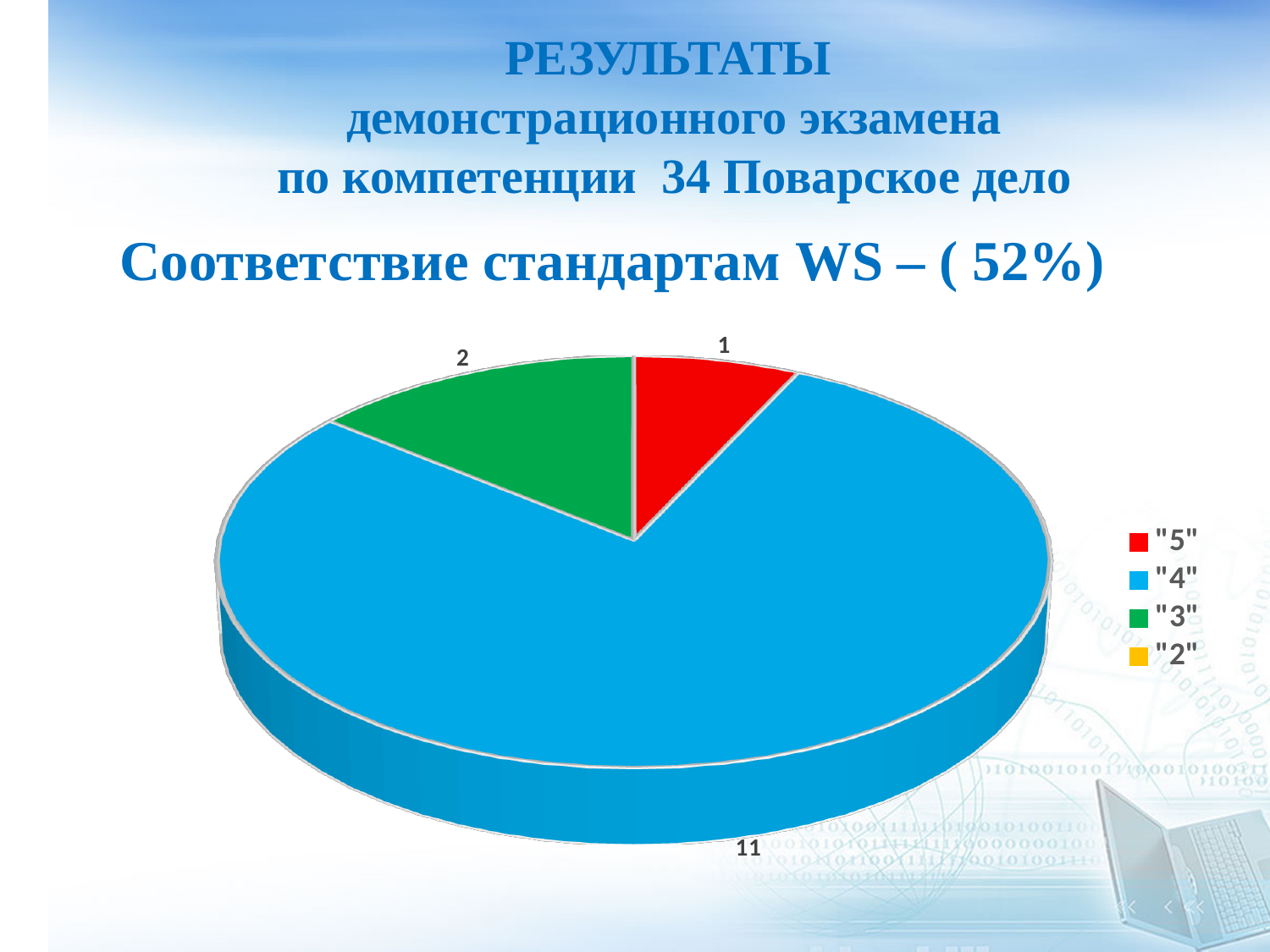
Which is larger in the pie chart, the value for "3" or the value for "5"? "3" What value is shown for the "3" slice of the pie chart? 2 How many slices with data labels are visible in the pie chart? 3 What colour is the "4" slice in the pie chart? blue Which category has the largest slice in the pie chart? "4" How many entries does the legend of the pie chart list? 4 What kind of chart is shown on the slide? pie chart What is the difference between the values for "3" and "5" in the pie chart? 1 Which of the labelled slices in the pie chart is the smallest? "5" What value is shown for the "4" slice of the pie chart? 11 What value is shown for the "5" slice of the pie chart? 1 What is the difference between the values for "4" and "3" in the pie chart? 9